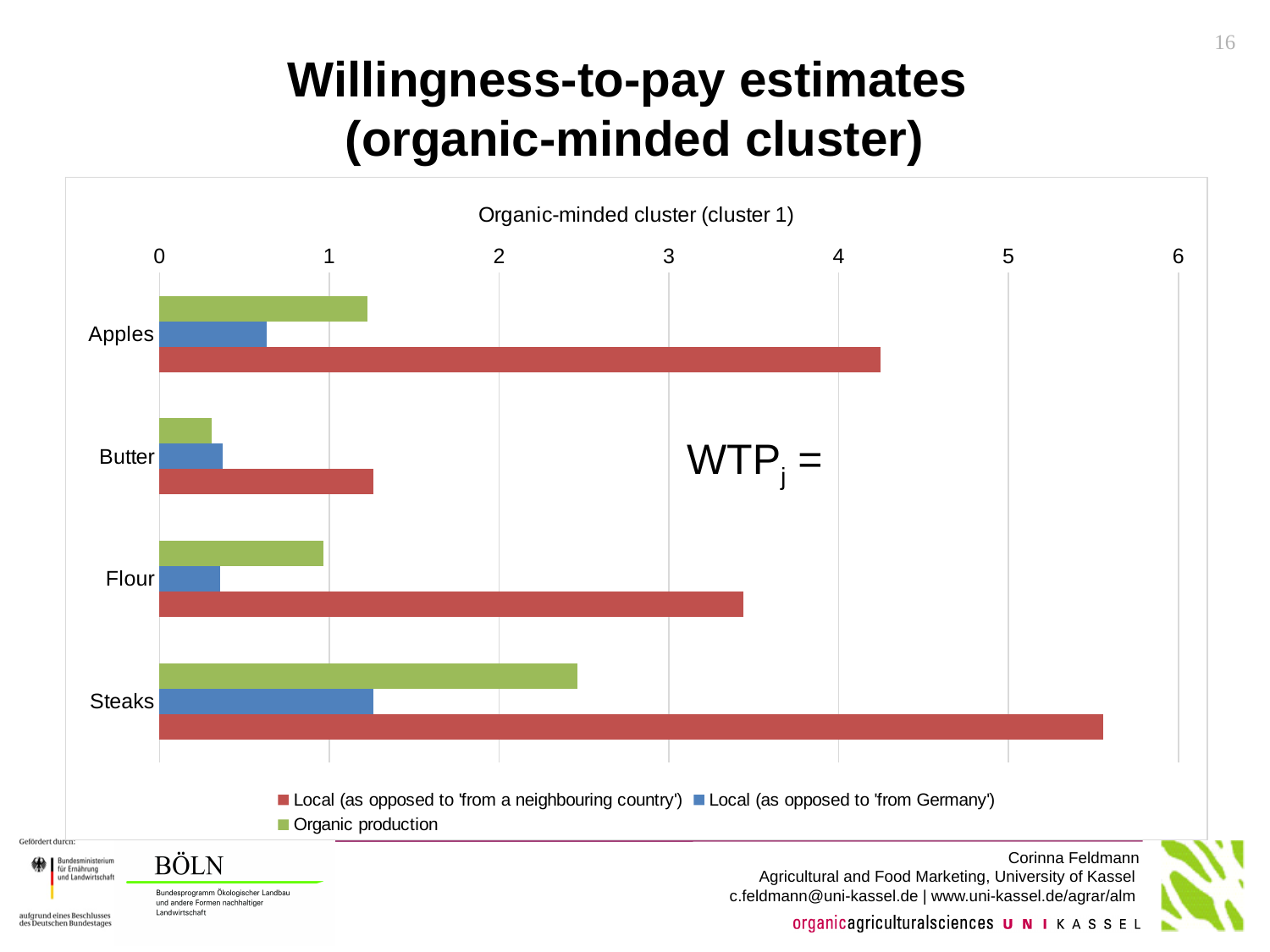
Which product has the highest value for 'Local (as opposed to 'from a neighbouring country')'? Steaks For Apples, which is larger: the 'Organic production' value or the 'Local (as opposed to 'from Germany')' value? Organic production Is the 'Local (as opposed to 'from a neighbouring country')' value for Flour greater or less than 4? less What is the title shown inside the chart area? Organic-minded cluster (cluster 1) What kind of chart is shown on the slide? Bar chart How many product categories are shown on the chart? 4 Which product has the highest 'Organic production' value? Steaks Is the 'Organic production' value for Butter greater or less than 1? less Is the 'Local (as opposed to 'from a neighbouring country')' value for Steaks greater or less than 5? greater Which product has the lowest value for 'Local (as opposed to 'from a neighbouring country')'? Butter Which product has the lowest 'Organic production' value? Butter How many series does the chart legend list? 3